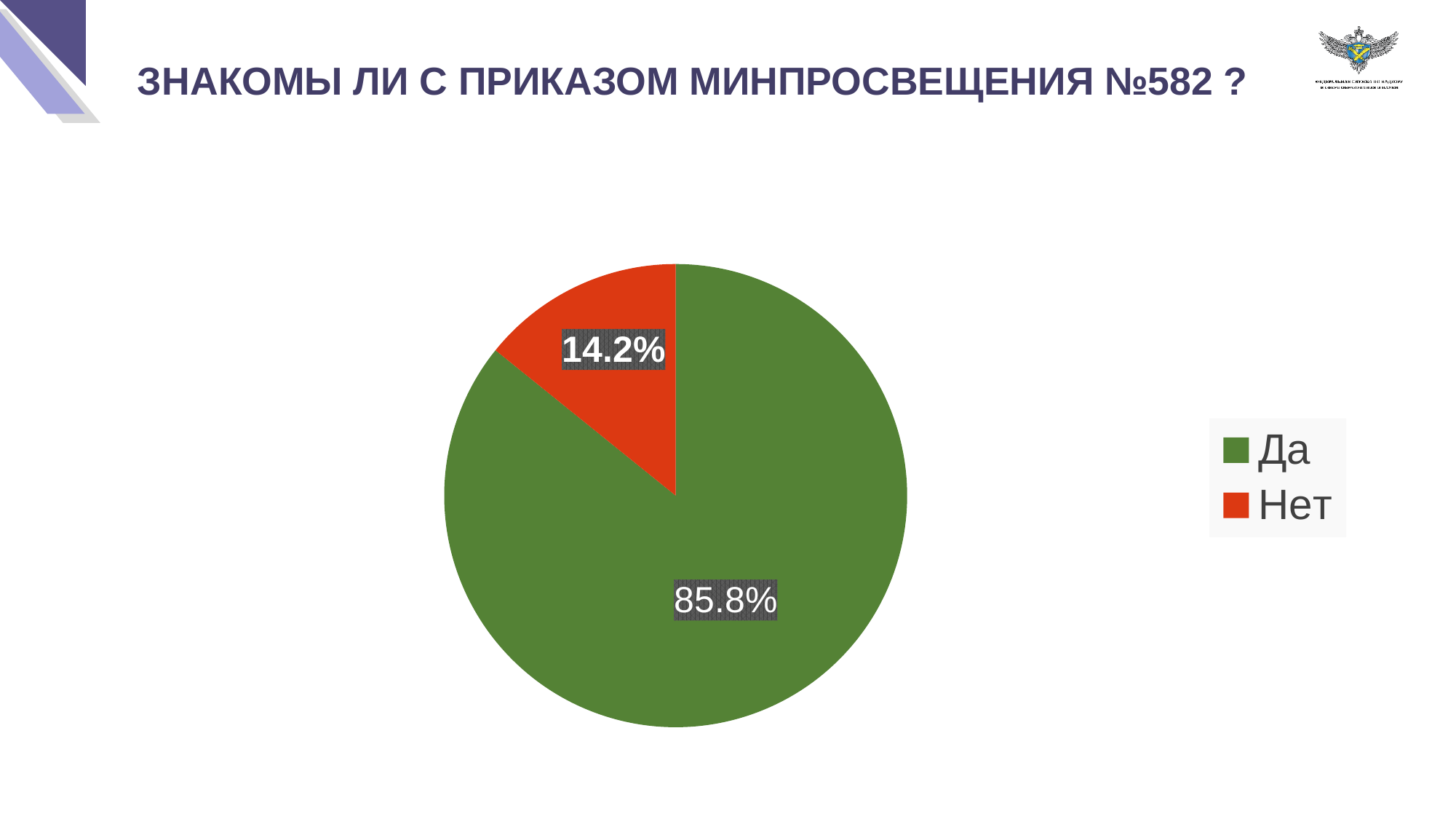
Which is larger, the "Да" slice or the "Нет" slice? Да What colour is the "Нет" slice? red What share of the pie does "Нет" take? 14.2% How many entries does the legend list? 2 What is the title of the slide above the chart? ЗНАКОМЫ ЛИ С ПРИКАЗОМ МИНПРОСВЕЩЕНИЯ №582 ? What is the difference in percentage points between the "Да" and "Нет" slices? 71.6 What kind of chart is shown on the slide? pie chart Which slice of the pie is the largest? Да How many slices does the pie chart have? 2 Which slice of the pie is the smallest? Нет What share of the pie does "Да" take? 85.8%